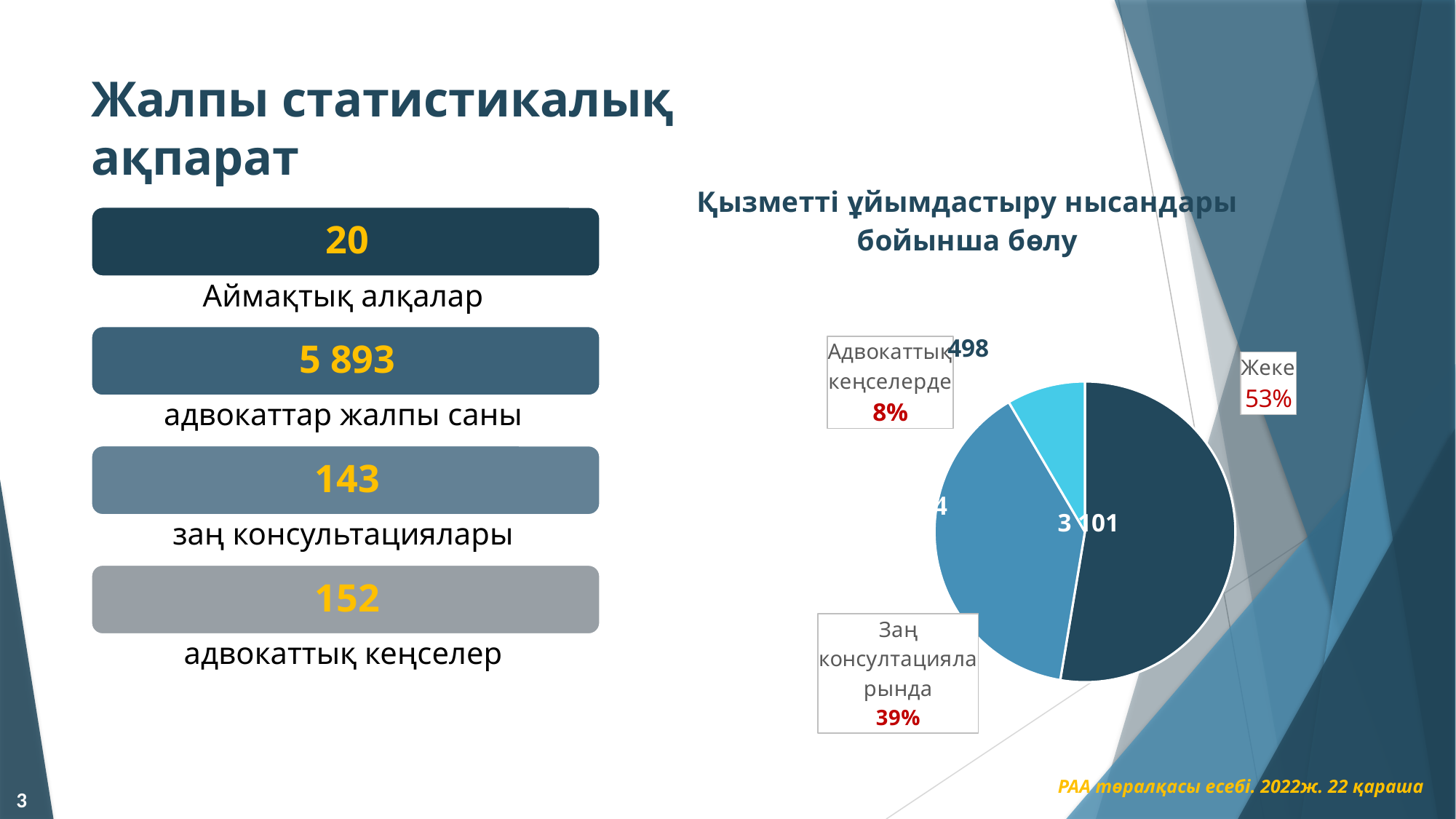
What is the title of the pie chart? Қызметті ұйымдастыру нысандары бойынша бөлу Which is larger in the pie chart, Жеке or Заң консултацияларында? Жеке What is the difference between the Жеке value (3 101) and the Адвокаттық кеңселерде value (498) in the pie chart? 2 603 What value is labelled on the Адвокаттық кеңселерде slice of the pie chart? 498 What share of the pie does the Жеке slice represent? 53% How many slices does the pie chart have? 3 What kind of chart is shown on the slide? pie chart What value is labelled on the Жеке slice of the pie chart? 3 101 Which slice of the pie chart is the smallest? Адвокаттық кеңселерде What share of the pie does the Адвокаттық кеңселерде slice represent? 8% Which slice of the pie chart is the largest? Жеке What share of the pie does the Заң консултацияларында slice represent? 39%